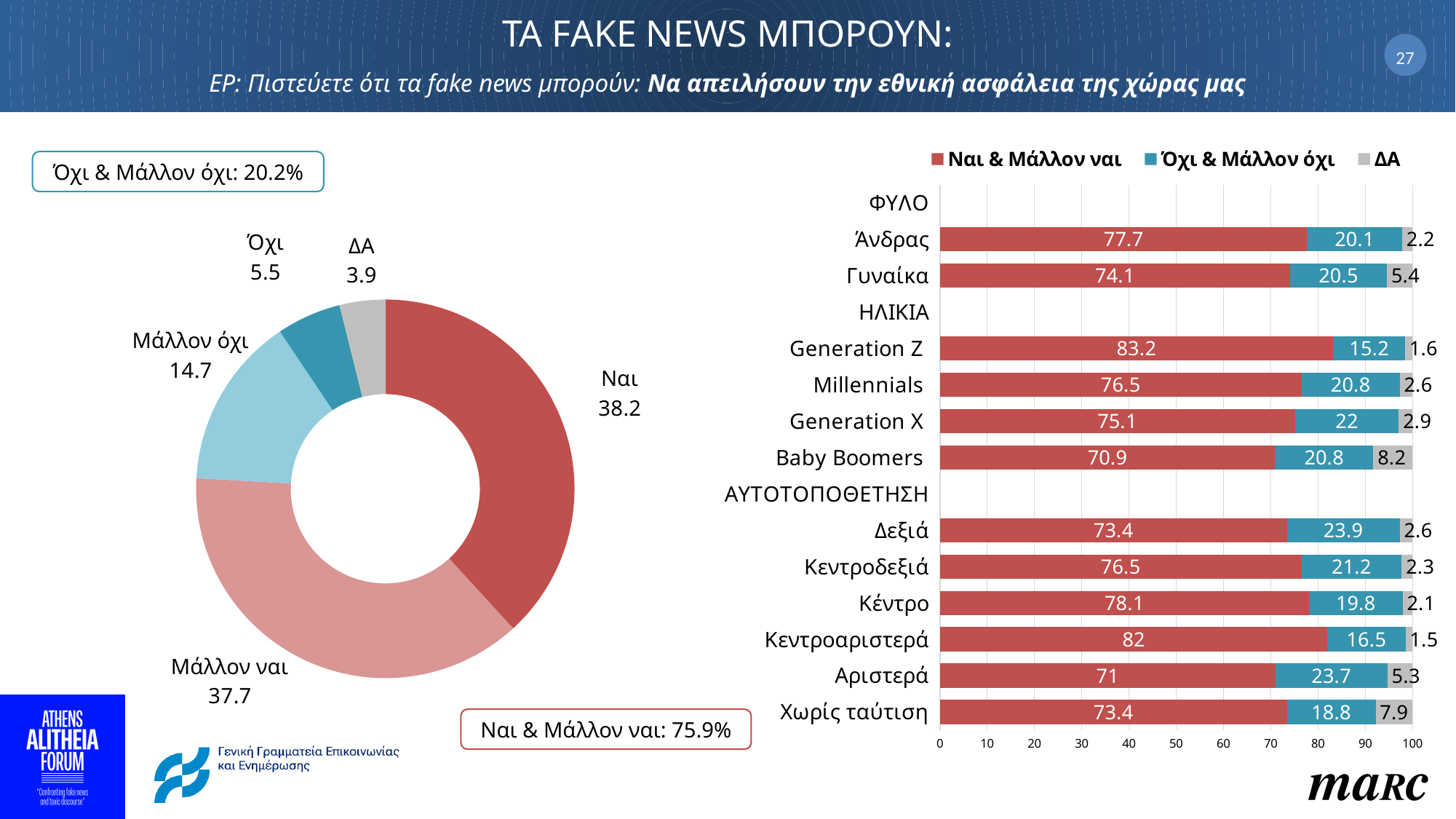
How many series does the legend of the bar chart on the right list? 3 In the pie chart on the left, what is the value for Ναι? 38.2 How many slices does the pie chart on the left have? 5 How many categories (bars) are plotted in the bar chart on the right? 12 What kind of chart is the chart on the right of the slide? bar chart What kind of chart is the chart on the left of the slide? doughnut chart In the bar chart on the right, which has the larger Όχι & Μάλλον όχι value, Κεντροαριστερά or Αριστερά? Αριστερά In the bar chart on the right, what is the ΔΑ value for Baby Boomers? 8.2 In the bar chart on the right, which age group has the highest Ναι & Μάλλον ναι value? Generation Z In the pie chart on the left, which category has the smallest value? ΔΑ In the bar chart on the right, what is the difference between the Ναι & Μάλλον ναι values for Άνδρας and Γυναίκα? 3.6 In the bar chart on the right, what is the Ναι & Μάλλον ναι value for Generation Z? 83.2